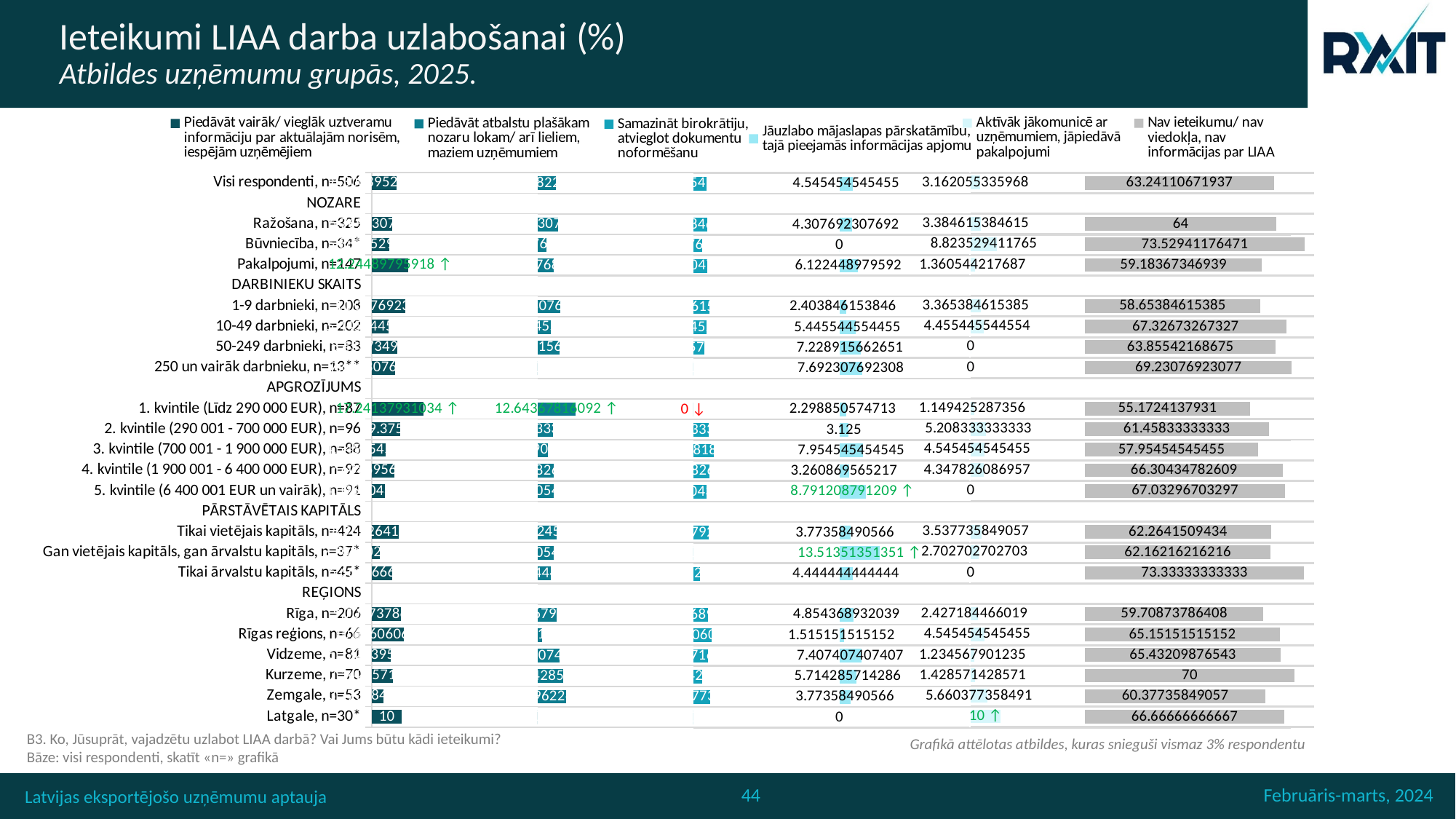
What is the difference between the "Nav ieteikumu/ nav viedokļa, nav informācijas par LIAA" values for "Kurzeme, n=70" and "Ražošana, n=325"? 6 How many series does the legend list? 6 What kind of chart is shown on the slide? bar chart What is the value of "Nav ieteikumu/ nav viedokļa, nav informācijas par LIAA" for "Kurzeme, n=70"? 70 Which has the larger value for "Aktīvāk jākomunicē ar uzņēmumiem, jāpiedāvā pakalpojumi": "Būvniecība, n=34*" or "Ražošana, n=325"? Būvniecība, n=34* What is the value of "Aktīvāk jākomunicē ar uzņēmumiem, jāpiedāvā pakalpojumi" for "Latgale, n=30*"? 10 Among the regions (REĢIONS), which has the highest value for "Nav ieteikumu/ nav viedokļa, nav informācijas par LIAA"? Kurzeme, n=70 What is the value of "Nav ieteikumu/ nav viedokļa, nav informācijas par LIAA" for "Ražošana, n=325"? 64 What is the value of "Jāuzlabo mājaslapas pārskatāmību, tajā pieejamās informācijas apjomu" for "Gan vietējais kapitāls, gan ārvalstu kapitāls, n=37*"? 13.51351351351 What is the value of "Nav ieteikumu/ nav viedokļa, nav informācijas par LIAA" for "Visi respondenti, n=506"? 63.24110671937 Among the turnover groups (APGROZĪJUMS), which has the lowest value for "Nav ieteikumu/ nav viedokļa, nav informācijas par LIAA"? 1. kvintile (Līdz 290 000 EUR), n=87 What is the value of "Jāuzlabo mājaslapas pārskatāmību, tajā pieejamās informācijas apjomu" for "2. kvintile (290 001 - 700 000 EUR), n=96"? 3.125